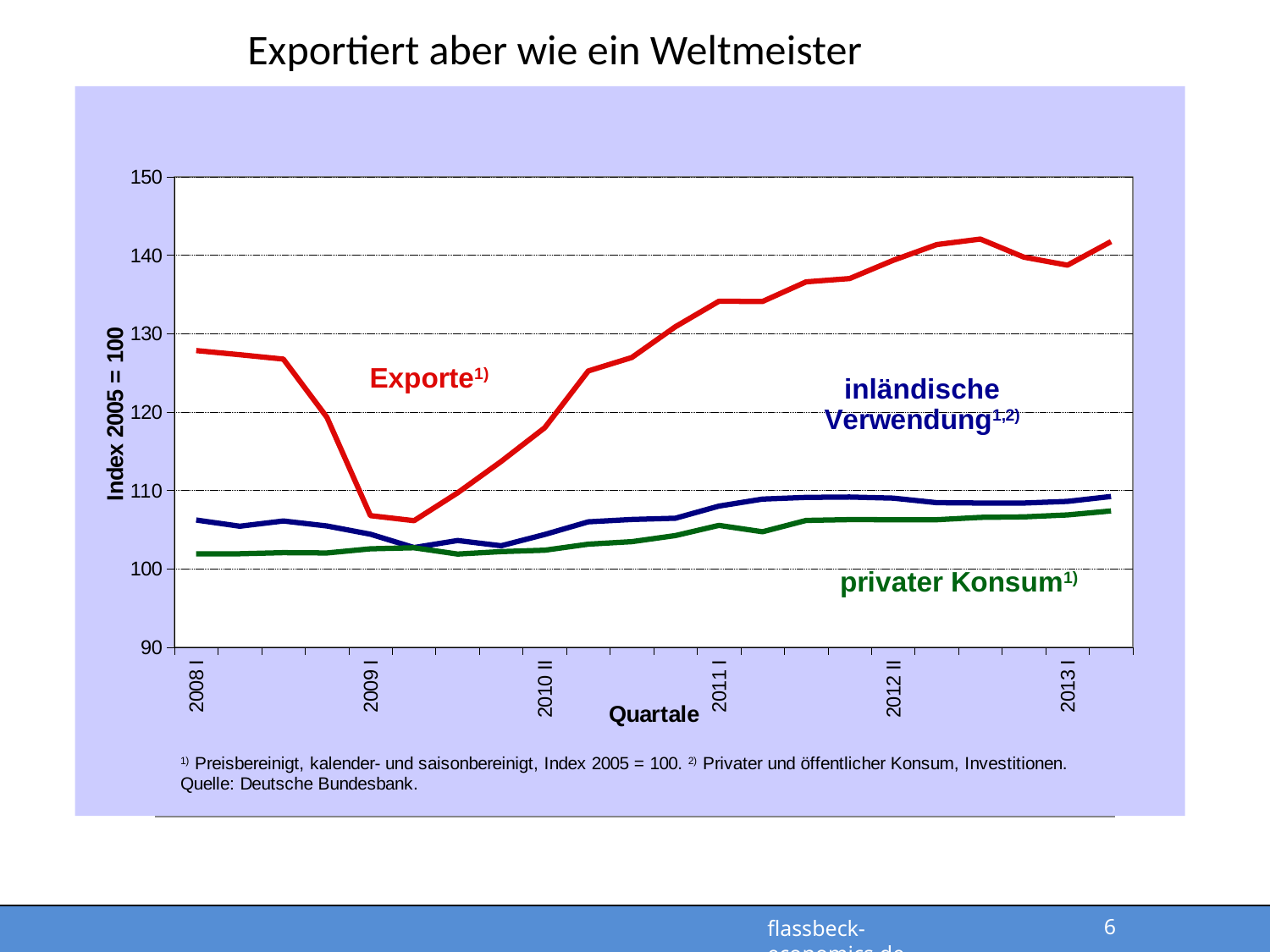
Which series has the lowest value at 2008 I? privater Konsum Which series has the highest value at 2013 I? Exporte Is the value of privater Konsum at 2008 I greater or less than 110? less Is the value of Exporte at 2013 I greater or less than 130? greater Is the value of Exporte at 2009 I greater or less than 110? less At 2008 I, which is larger: inländische Verwendung or privater Konsum? inländische Verwendung What kind of chart is shown on the slide? line chart How many data series are plotted in the chart? 3 What is the label of the y axis? Index 2005 = 100 Does the Exporte series rise or fall between 2008 I and 2009 I? fall